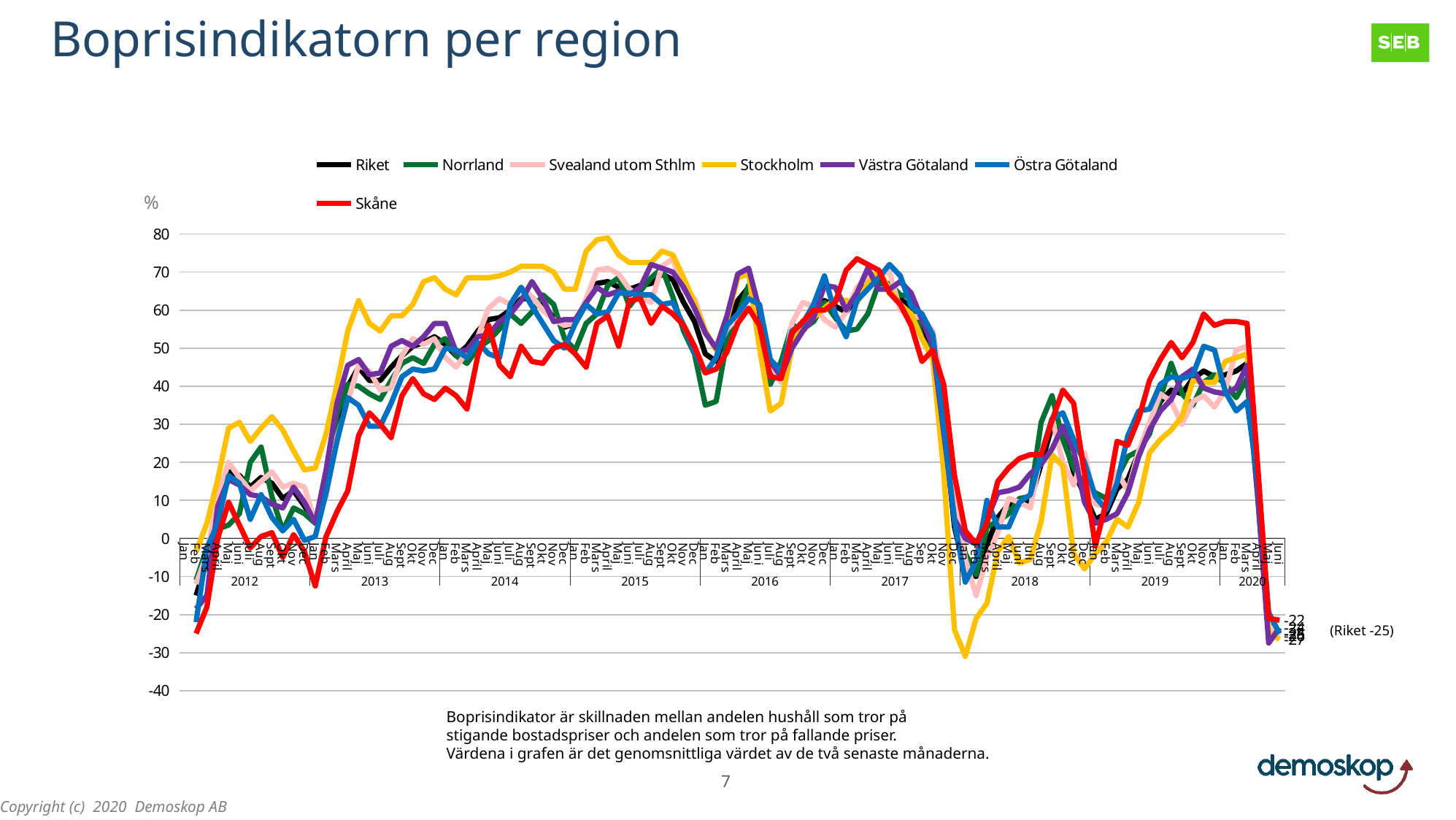
What kind of chart is shown on the slide? line chart How many series does the legend list? 7 Which series reaches the lowest value anywhere on the chart? Stockholm In 2012, which series is higher, Stockholm or Skåne? Stockholm What colour is the Skåne line? red Is the lowest value for Stockholm in early 2018 greater or less than -20? less What is the latest value for Riket, as printed on the slide? -25 Is the value for Skåne in late 2019 greater or less than 50? greater How many years are labelled on the x axis? 9 Which series reaches the highest value anywhere on the chart? Stockholm Do the values generally rise or fall from 2012 to 2015? rise Is the peak value for Stockholm in 2015 greater or less than 70? greater